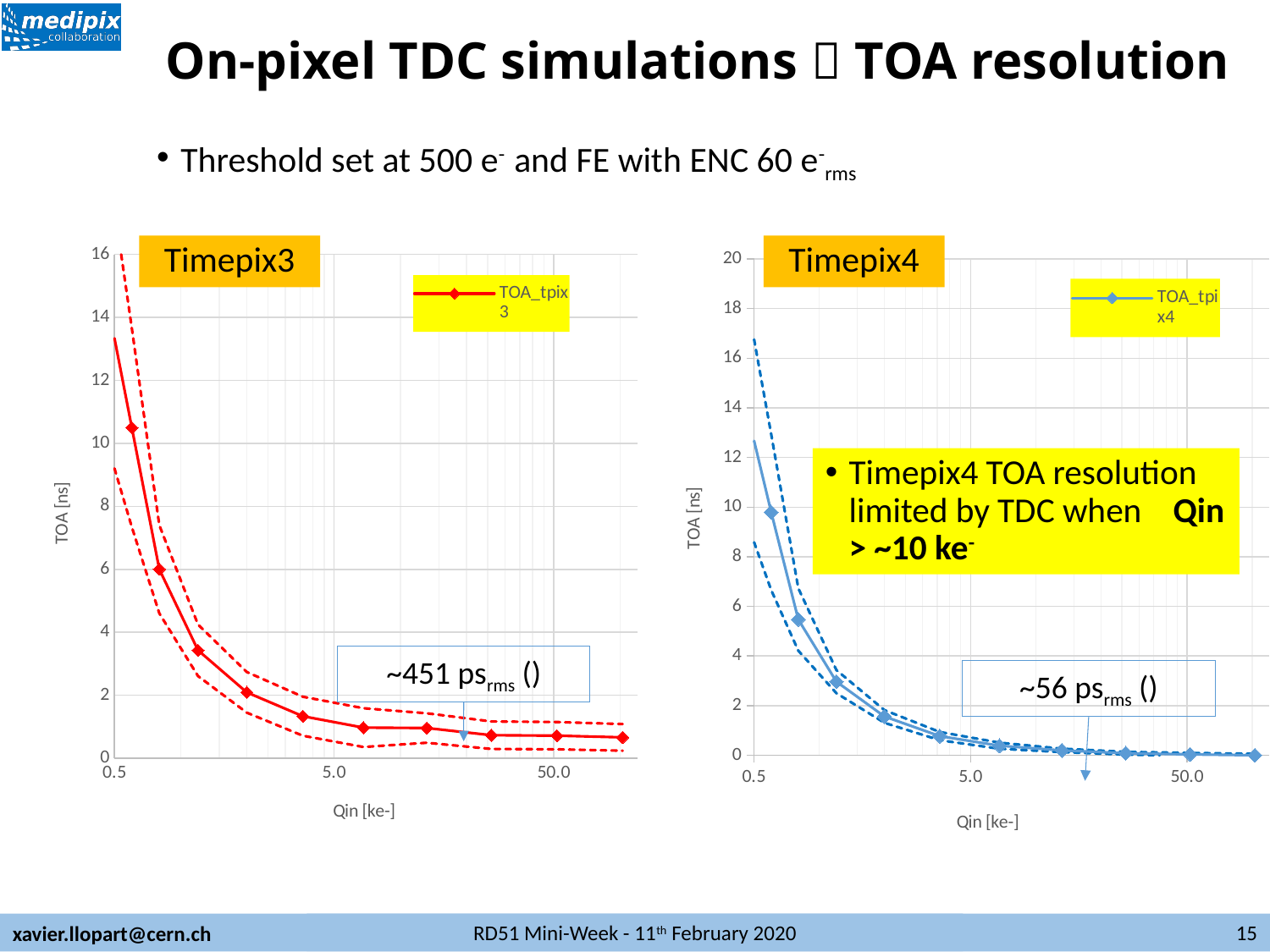
In the Timepix4 chart, does the TOA value rise or fall as Qin increases along the x axis? fall How many series does the legend of the Timepix4 chart list? 1 In the Timepix4 chart, is the TOA value at Qin = 50.0 ke- greater or less than 2 ns? less What is the legend entry of the series plotted in the Timepix3 chart? TOA_tpix3 In the Timepix3 chart, is the TOA value of the first (leftmost) data point greater or less than 10 ns? greater In the Timepix4 chart, which has the larger TOA value: the leftmost data point or the data point at Qin = 50.0 ke-? the leftmost data point In the Timepix3 chart, is the TOA value at Qin = 5.0 ke- greater or less than 2 ns? less In the Timepix3 chart, does the TOA value rise or fall as Qin increases along the x axis? fall What kind of chart is the Timepix4 chart on the right? line chart How many series does the legend of the Timepix3 chart list? 1 What kind of chart is the Timepix3 chart on the left? line chart